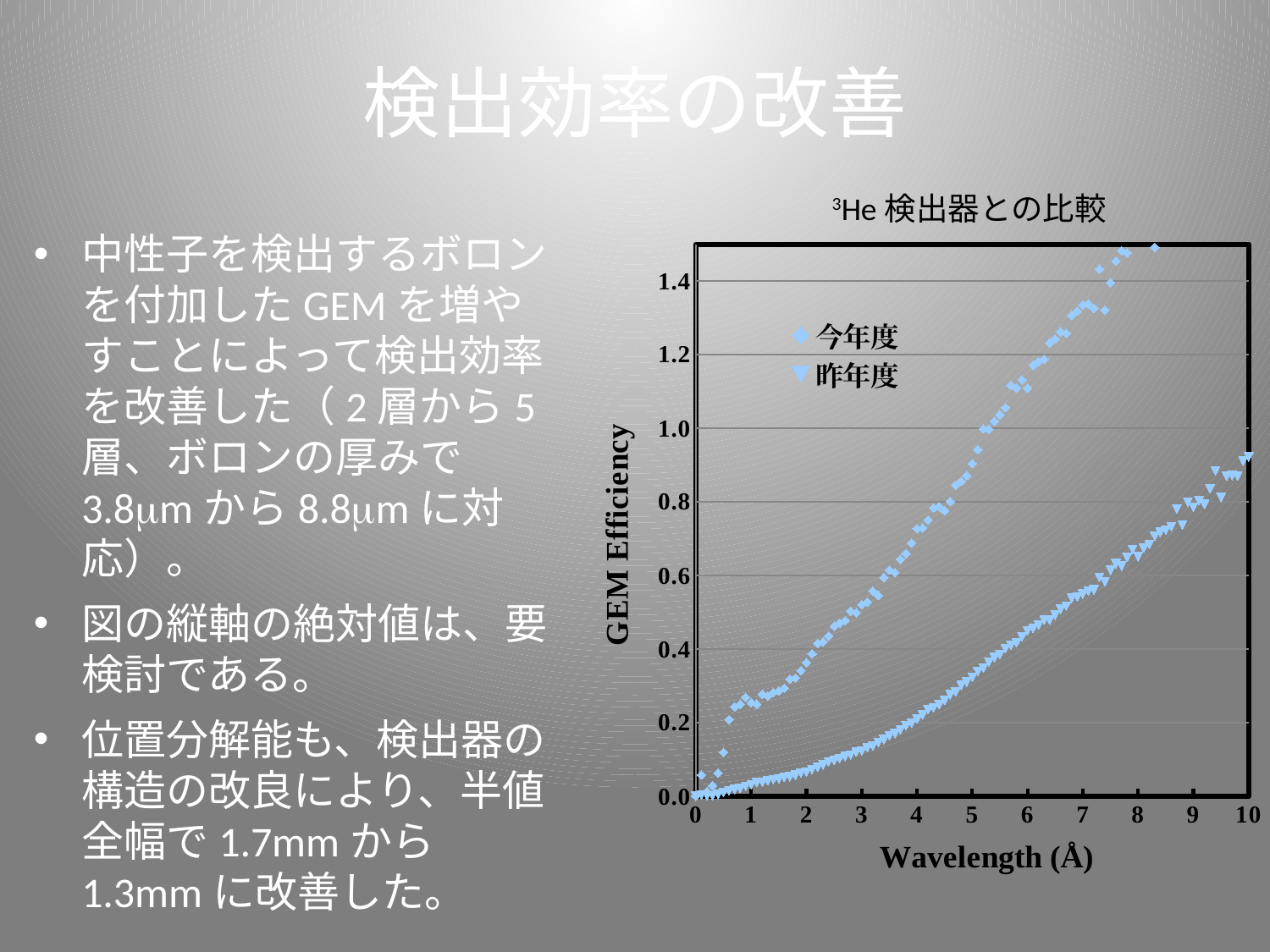
What kind of chart is shown on the slide? scatter chart What is the label of the x axis of the chart? Wavelength (Å) Is the GEM Efficiency for 昨年度 at a wavelength of 10 Å greater or less than 0.8? greater What are the two series named in the chart legend? 今年度 and 昨年度 Is the GEM Efficiency for 今年度 at a wavelength of 3 Å greater or less than 0.6? less Is the GEM Efficiency for 今年度 at a wavelength of 7 Å greater or less than 1.2? greater How many series does the chart legend list? 2 At a wavelength of 6 Å, which series has the higher GEM Efficiency, 今年度 or 昨年度? 今年度 Does the GEM Efficiency for 今年度 rise or fall as the wavelength increases? rise